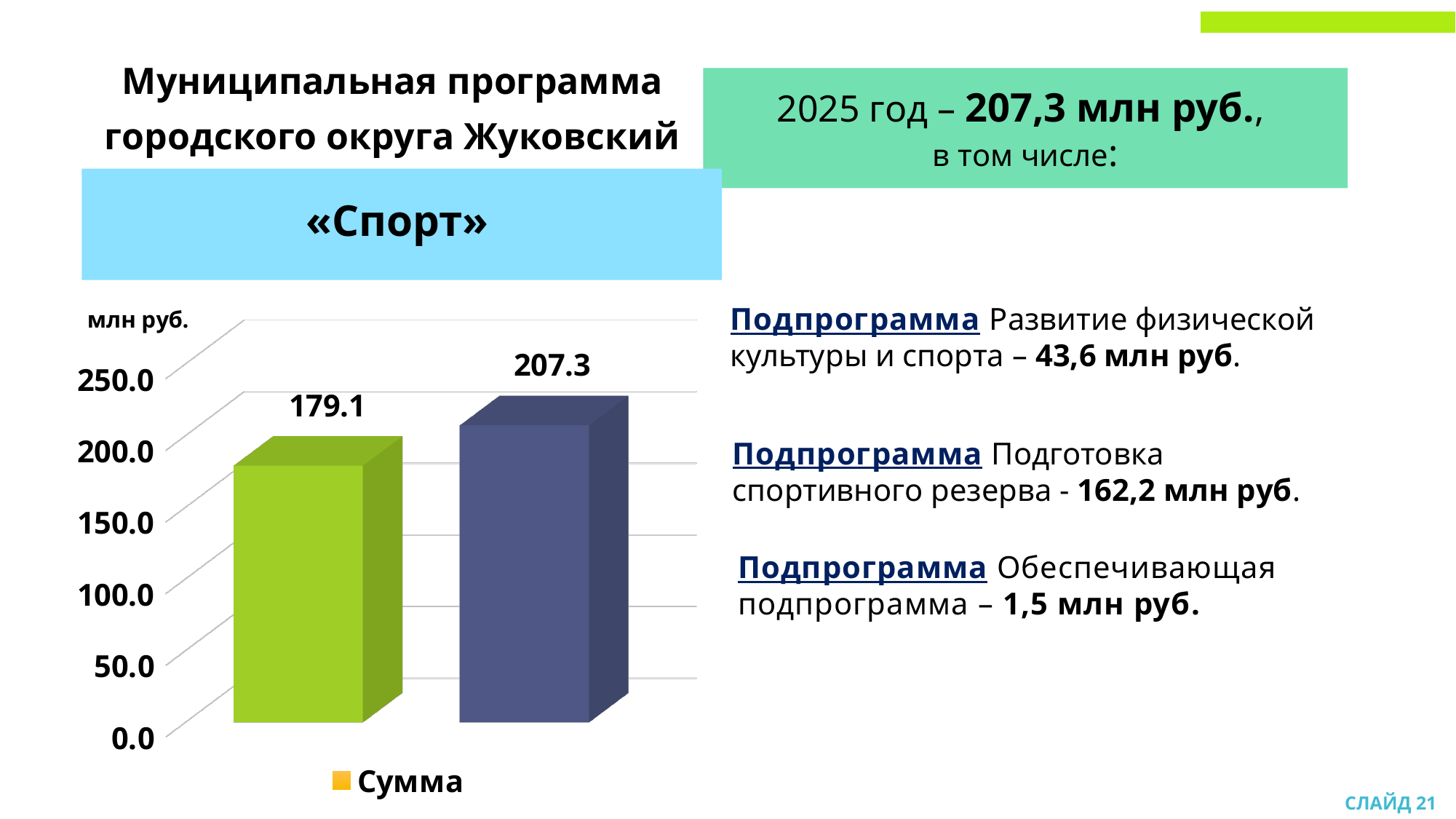
How many bars are plotted in the chart? 2 Do the bar values rise or fall from left to right? rise Which bar has the lower value, the left green bar or the right blue bar? the left green bar What kind of chart is shown on the slide? bar chart What is the value shown on the left (green) bar of the chart? 179.1 What is the name of the series shown in the chart legend? Сумма What is the difference between the right bar's value (207.3) and the left bar's value (179.1)? 28.2 Is the value of the left green bar larger or smaller than the value of the right blue bar? smaller Which bar has the higher value, the left green bar or the right blue bar? the right blue bar What is the value shown on the right (blue) bar of the chart? 207.3 Is the value of the right blue bar greater or less than 200.0? greater How many series does the chart legend list? 1